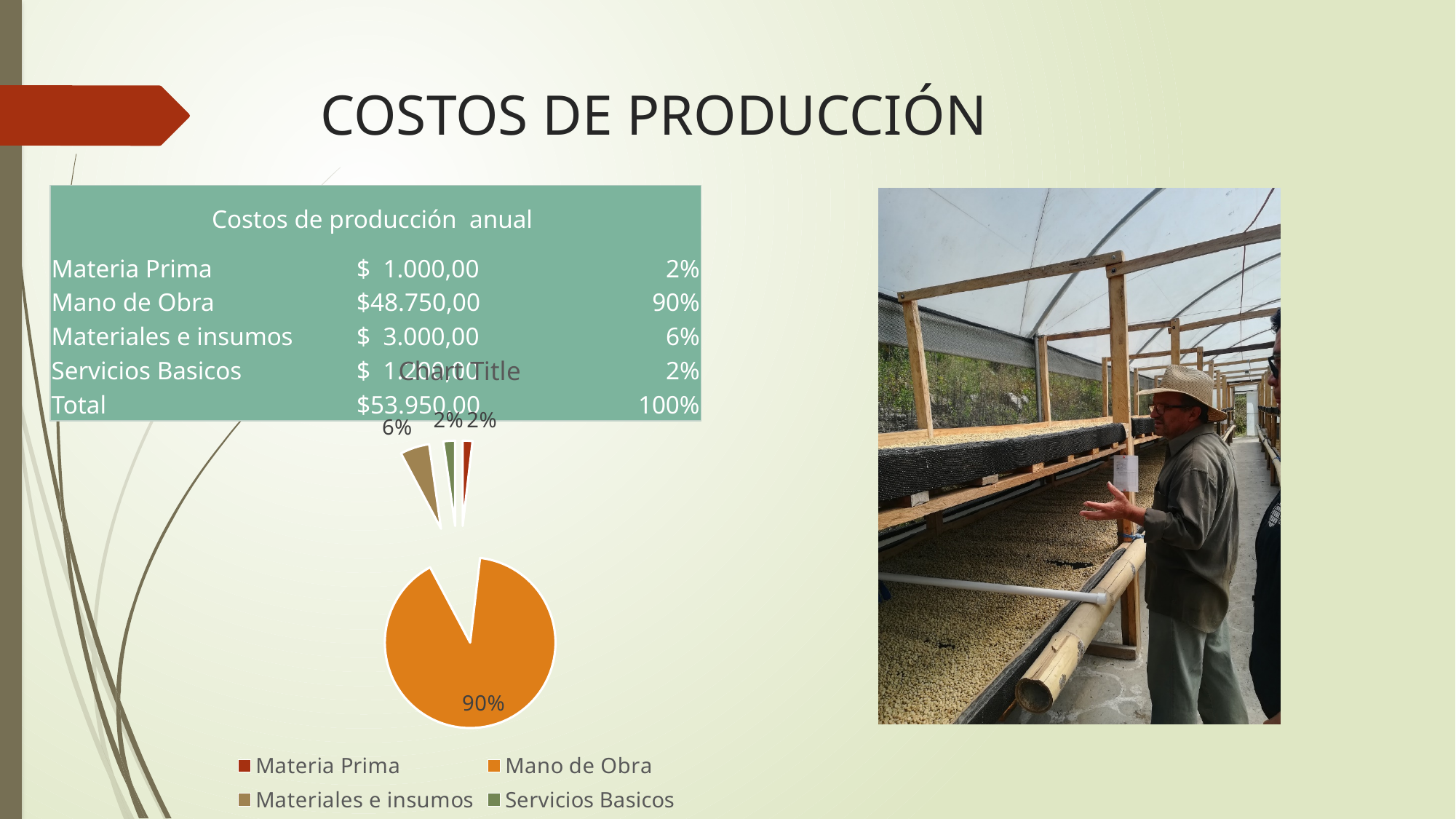
What share of the pie does Mano de Obra represent? 90% How many entries does the legend list? 4 What colour is the Mano de Obra slice in the pie chart? orange How many slices does the pie chart have? 4 What share of the pie does Materia Prima represent? 2% What share of the pie does Materiales e insumos represent? 6% Which category has the largest slice of the pie? Mano de Obra What kind of chart is shown on the slide? pie chart Which is larger, the slice for Materiales e insumos or the slice for Materia Prima? Materiales e insumos What is the title shown on the pie chart? Chart Title What is the difference in percentage points between the Mano de Obra slice and the Materiales e insumos slice? 84%